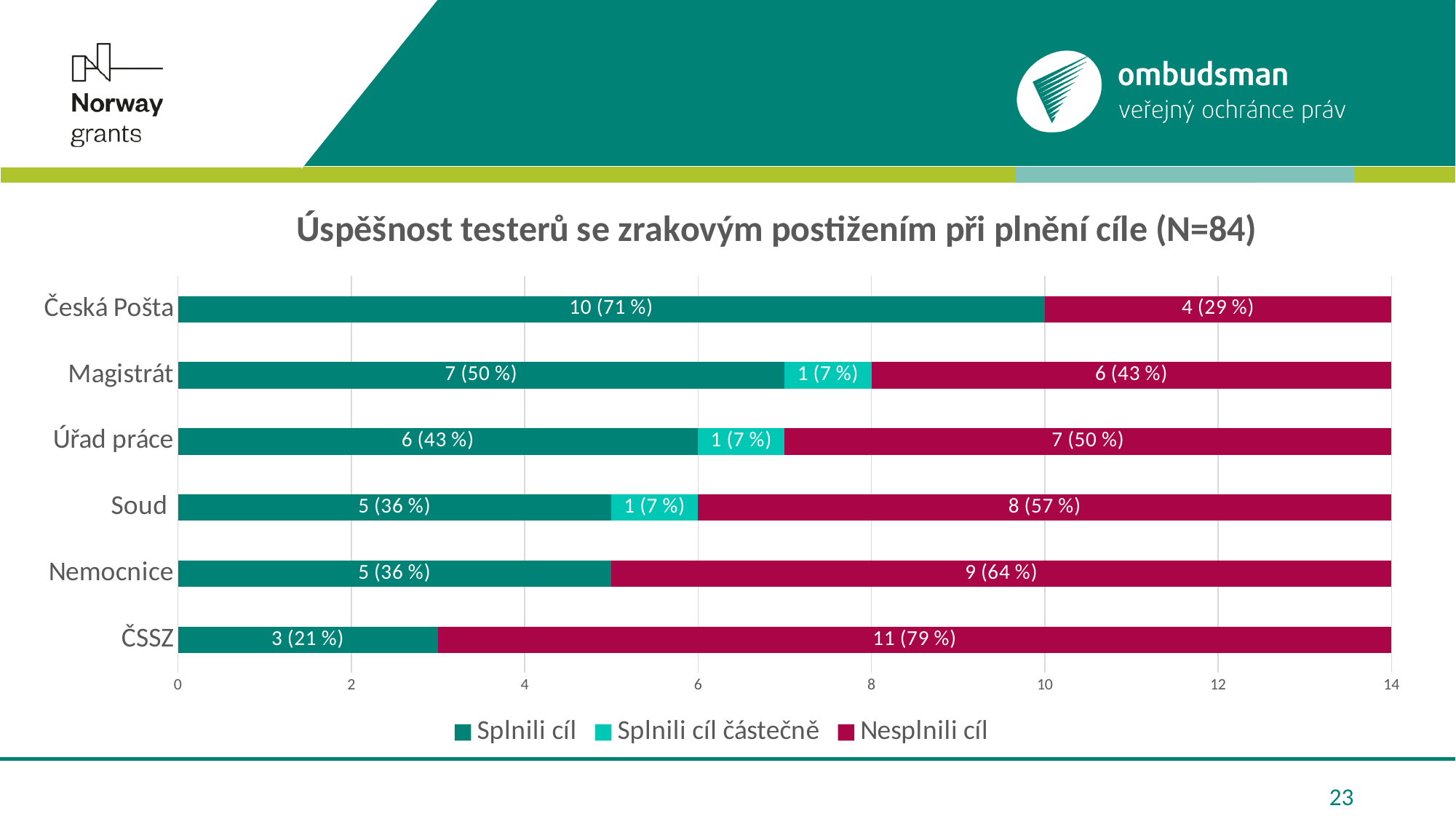
Which is larger: the Splnili cíl count for Úřad práce or for Soud? Úřad práce What is the title of the chart? Úspěšnost testerů se zrakovým postižením při plnění cíle (N=84) What is the data label for Splnili cíl částečně for Magistrát? 1 (7 %) What kind of chart is shown on the slide? Stacked bar chart What is the total of the stacked bar for Magistrát? 14 How many categories are shown on the vertical axis? 6 Which category has the lowest Nesplnili cíl value? Česká Pošta What is the difference between the Nesplnili cíl count for ČSSZ and for Česká Pošta? 7 What is the data label for Splnili cíl for Česká Pošta? 10 (71 %) What is the data label for Nesplnili cíl for ČSSZ? 11 (79 %) Which category has the highest Splnili cíl value? Česká Pošta How many series does the legend list? 3